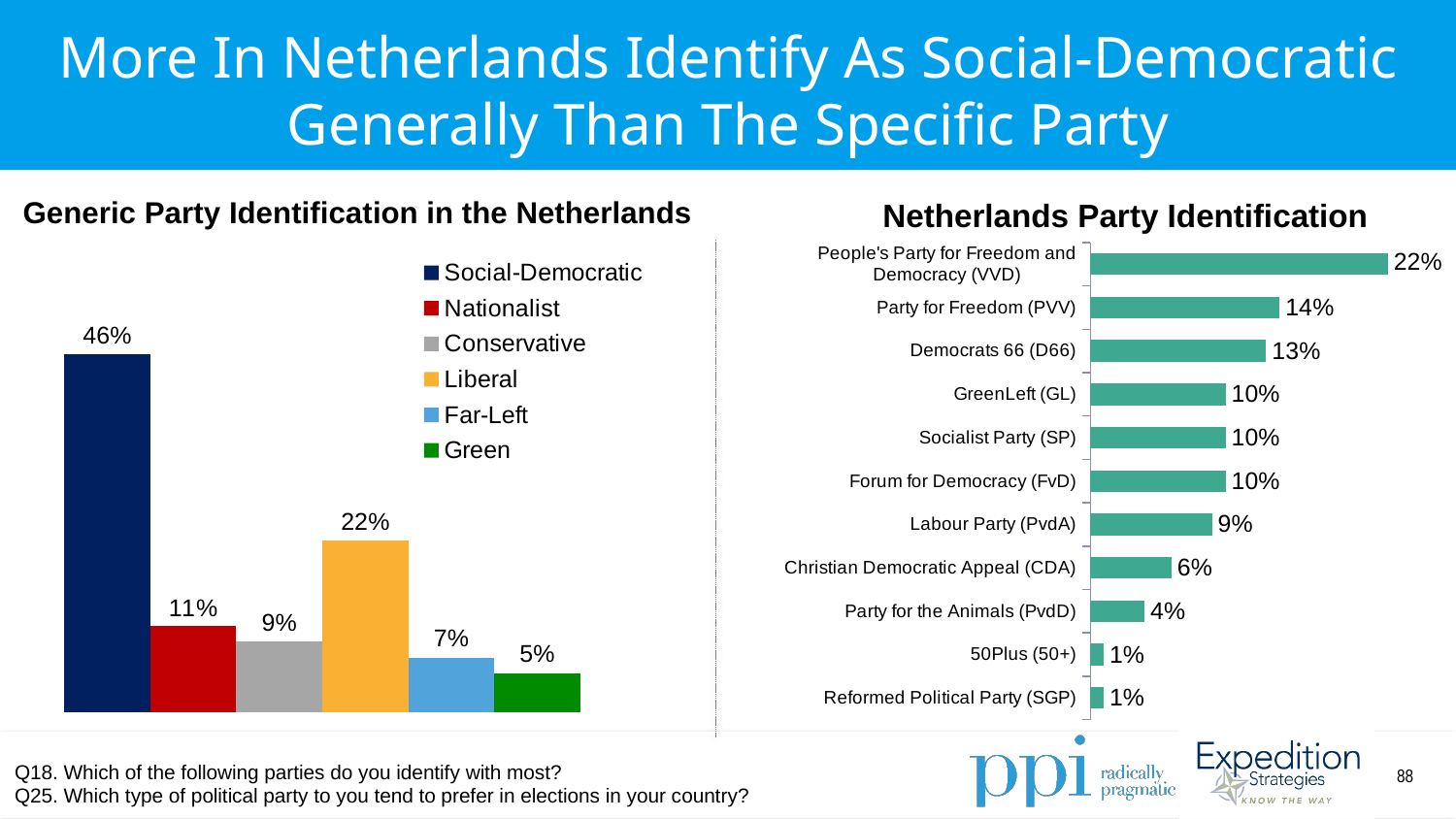
In the 'Generic Party Identification in the Netherlands' chart, what is the value for Liberal? 22% In the 'Generic Party Identification in the Netherlands' chart, what is the difference between Social-Democratic and Liberal? 24 percentage points In the 'Generic Party Identification in the Netherlands' chart, how many series does the legend list? 6 What kind of chart is the 'Netherlands Party Identification' chart? Bar chart In the 'Generic Party Identification in the Netherlands' chart, what percentage identify as Social-Democratic? 46% In the 'Netherlands Party Identification' chart, what is the value for Party for Freedom (PVV)? 14% In the 'Generic Party Identification in the Netherlands' chart, which is larger, Nationalist or Conservative? Nationalist In the 'Generic Party Identification in the Netherlands' chart, what colour is the Liberal bar? Orange In the 'Netherlands Party Identification' chart, how many parties are listed? 11 In the 'Netherlands Party Identification' chart, what is the difference between Democrats 66 (D66) and Labour Party (PvdA)? 4 percentage points In the 'Generic Party Identification in the Netherlands' chart, which category has the lowest value? Green In the 'Netherlands Party Identification' chart, which party has the highest value? People's Party for Freedom and Democracy (VVD)